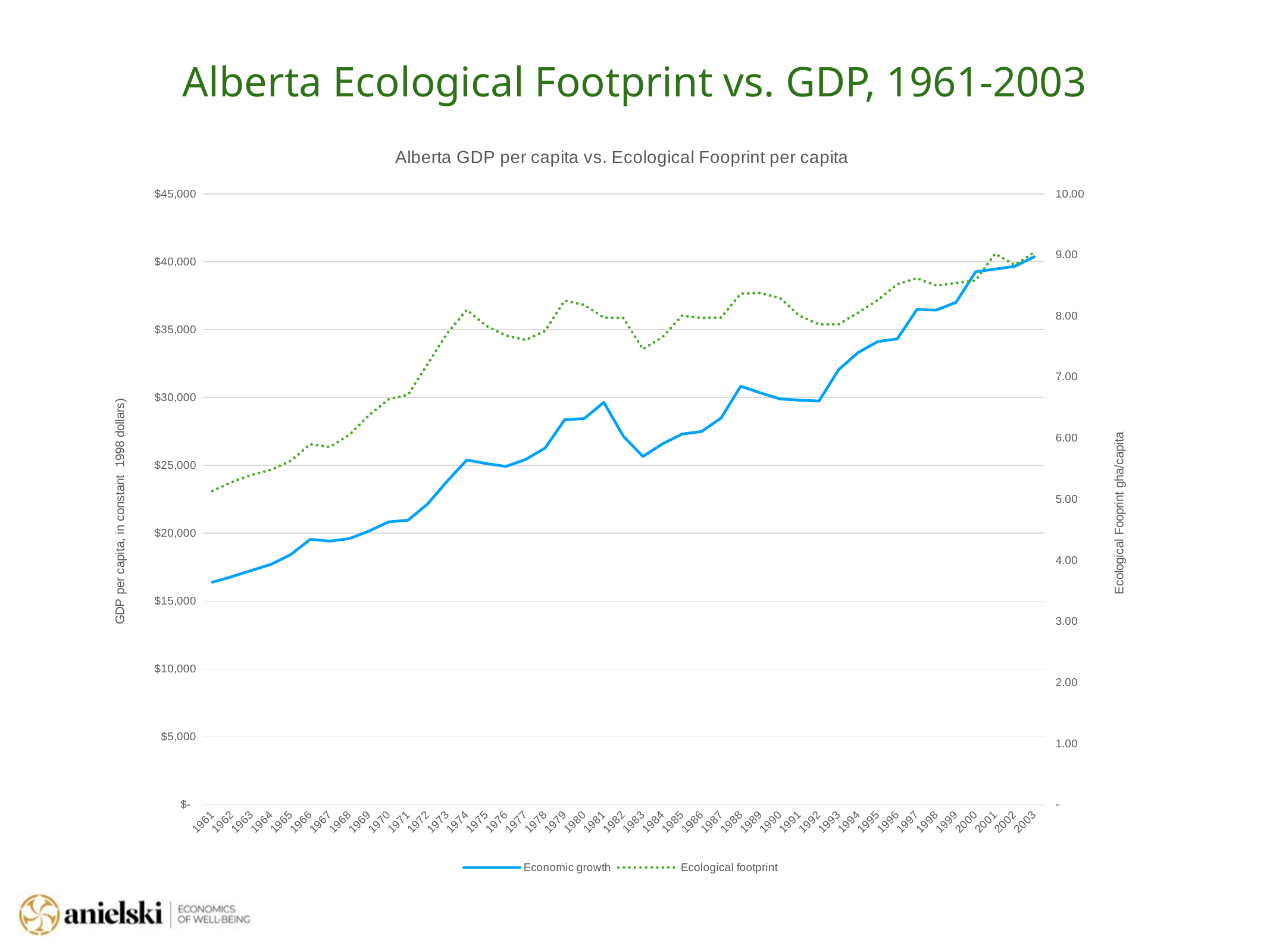
How many series does the legend list? 2 Is the Economic growth value for 1961 greater or less than $20,000? less Is the Ecological footprint value for 1983 greater or less than 8.00? less How many years are plotted along the x axis? 43 What is the label of the right-hand vertical axis? Ecological Fooprint gha/capita What kind of chart is shown on the slide? line chart In which year is the Ecological footprint value lowest? 1961 In which year is the Economic growth value lowest? 1961 Which two series are listed in the legend? Economic growth and Ecological footprint Overall, does the Economic growth line rise or fall from 1961 to 2003? rise Is the Economic growth value for 1997 greater or less than $35,000? greater In which year is the Economic growth value highest? 2003